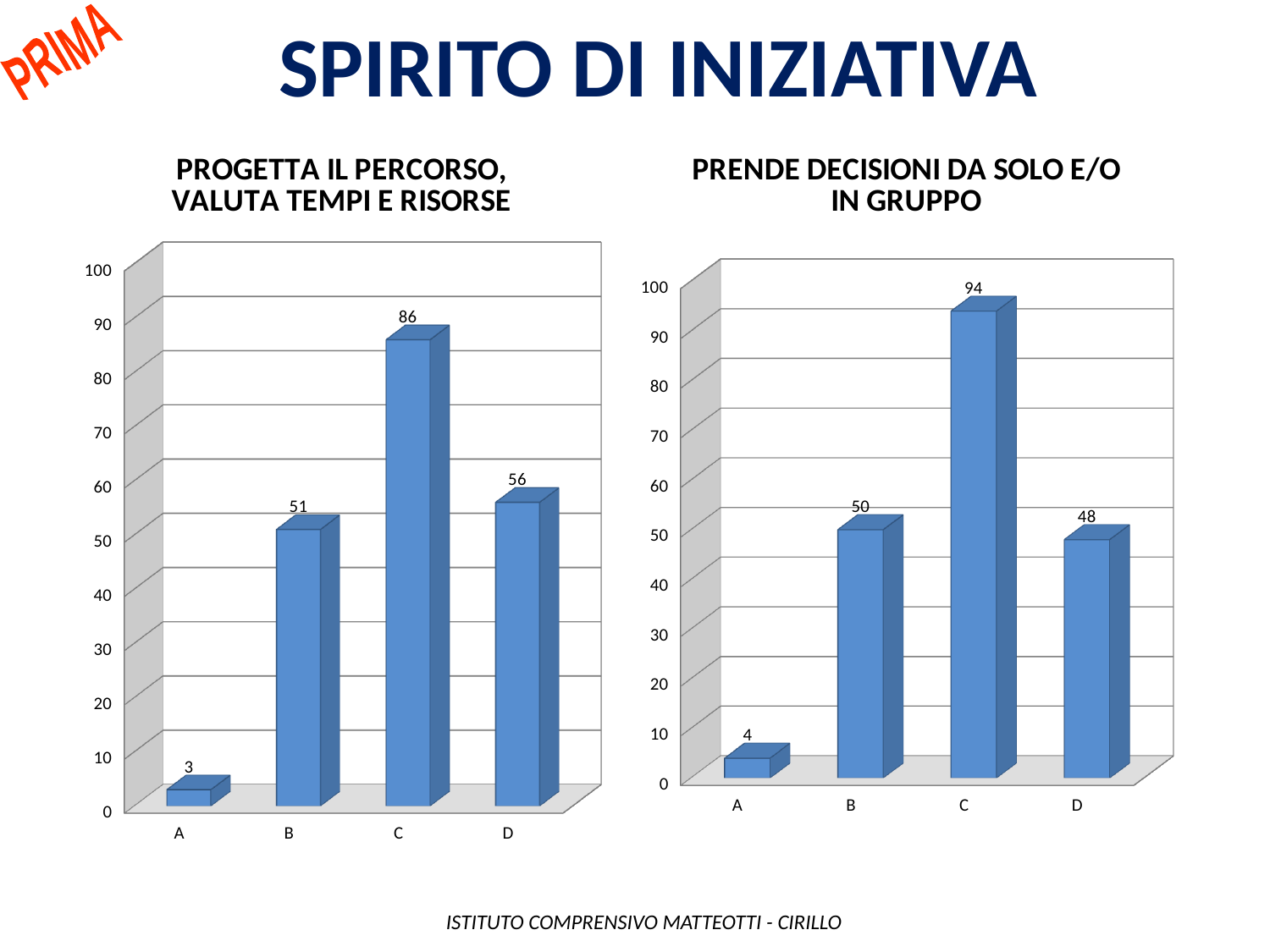
In the left chart, which category has the lowest value? A What kind of chart is the chart titled 'PRENDE DECISIONI DA SOLO E/O IN GRUPPO'? bar chart In the chart titled 'PROGETTA IL PERCORSO, VALUTA TEMPI E RISORSE', what is the value for category C? 86 In the left chart, is the value for C greater or less than 80? greater In the right chart, which category has the highest value? C In the left chart, what is the difference between the values for D and B? 5 In the chart titled 'PRENDE DECISIONI DA SOLO E/O IN GRUPPO', what is the value for category A? 4 How many categories are shown in the left chart? 4 In the left chart, what is the value for category B? 51 What is the title of the chart on the right of the slide? PRENDE DECISIONI DA SOLO E/O IN GRUPPO In the right chart, which is larger, the value for B or the value for D? B In the right chart, what is the difference between the values for C and B? 44